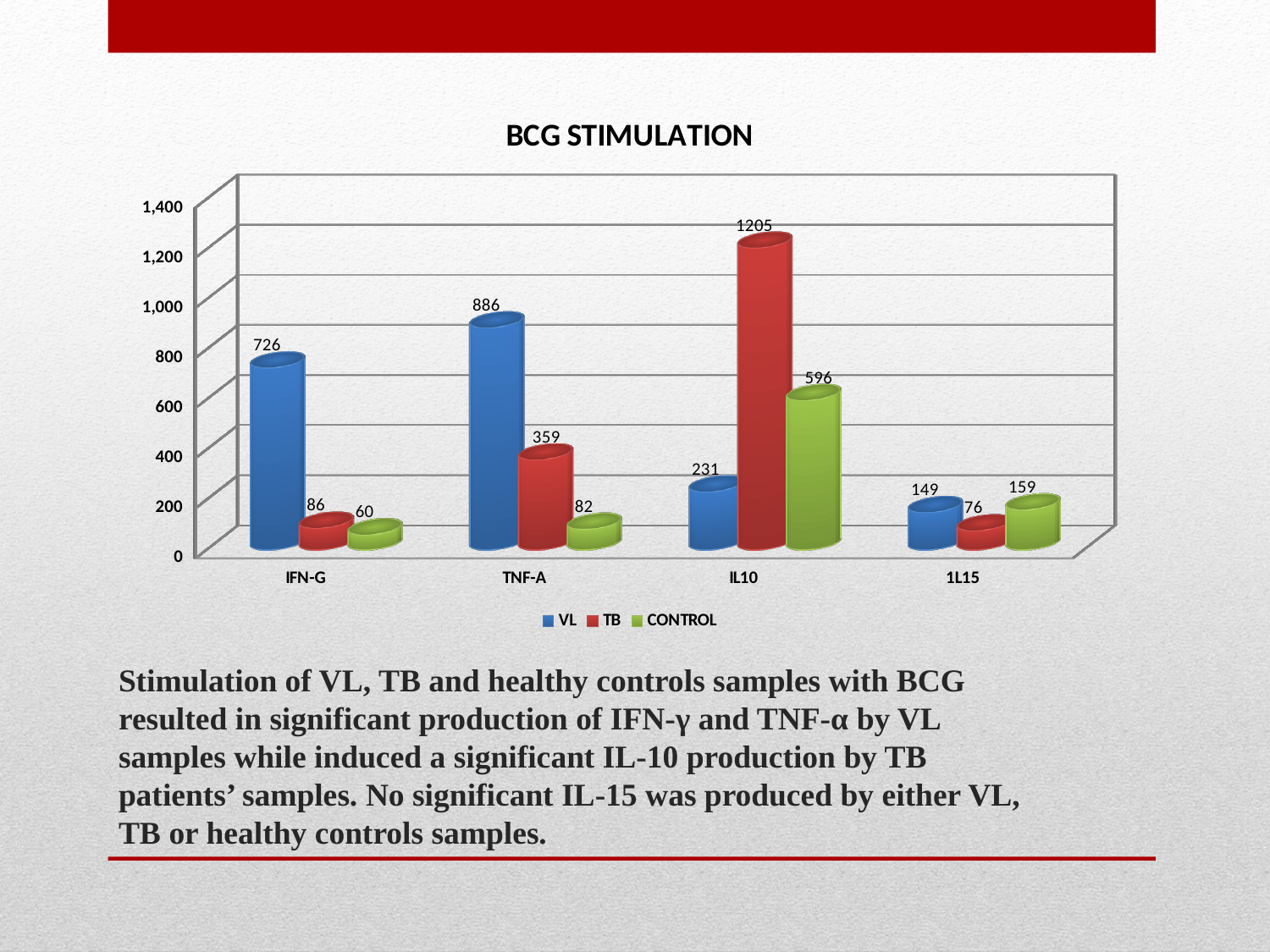
Which category has the highest TB value? IL10 Is the VL value for TNF-A greater or less than 800? greater How many series does the legend list? 3 What is the VL value for IFN-G? 726 What is the title of the chart? BCG STIMULATION Which category has the lowest VL value? 1L15 What is the difference between the VL and TB values for TNF-A? 527 What is the CONTROL value for TNF-A? 82 What is the TB value for IL10? 1205 How many categories are shown on the x axis? 4 What kind of chart is shown? bar chart Which is larger for IL10, the TB value or the CONTROL value? TB